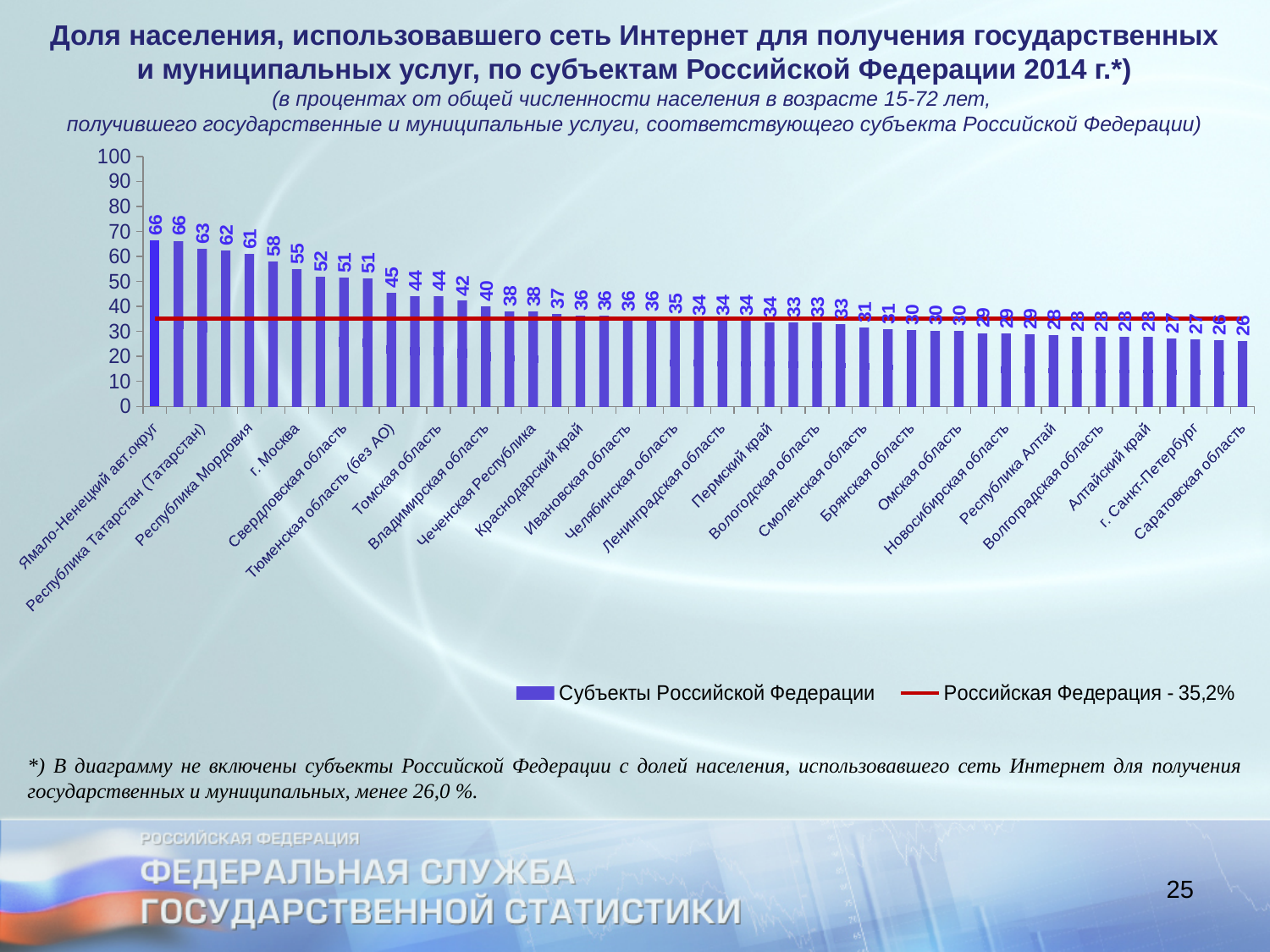
What is the value for Ямало-Ненецкий авт.округ? 66 What is the value for г. Москва? 55 What is the value for Республика Мордовия? 61 What is the difference between the values for Ямало-Ненецкий авт.округ and Саратовская область? 40 Is the value for Саратовская область greater or less than 30? less Is the value for Ямало-Ненецкий авт.округ greater or less than 60? greater How many bars are plotted in the chart? 47 What kind of chart is shown on the slide? bar chart Do the bar values rise or fall from left to right along the x axis? fall What is the value for Саратовская область? 26 What value does the legend give for the red line 'Российская Федерация'? 35,2% Which has the larger value, Ямало-Ненецкий авт.округ or Саратовская область? Ямало-Ненецкий авт.округ